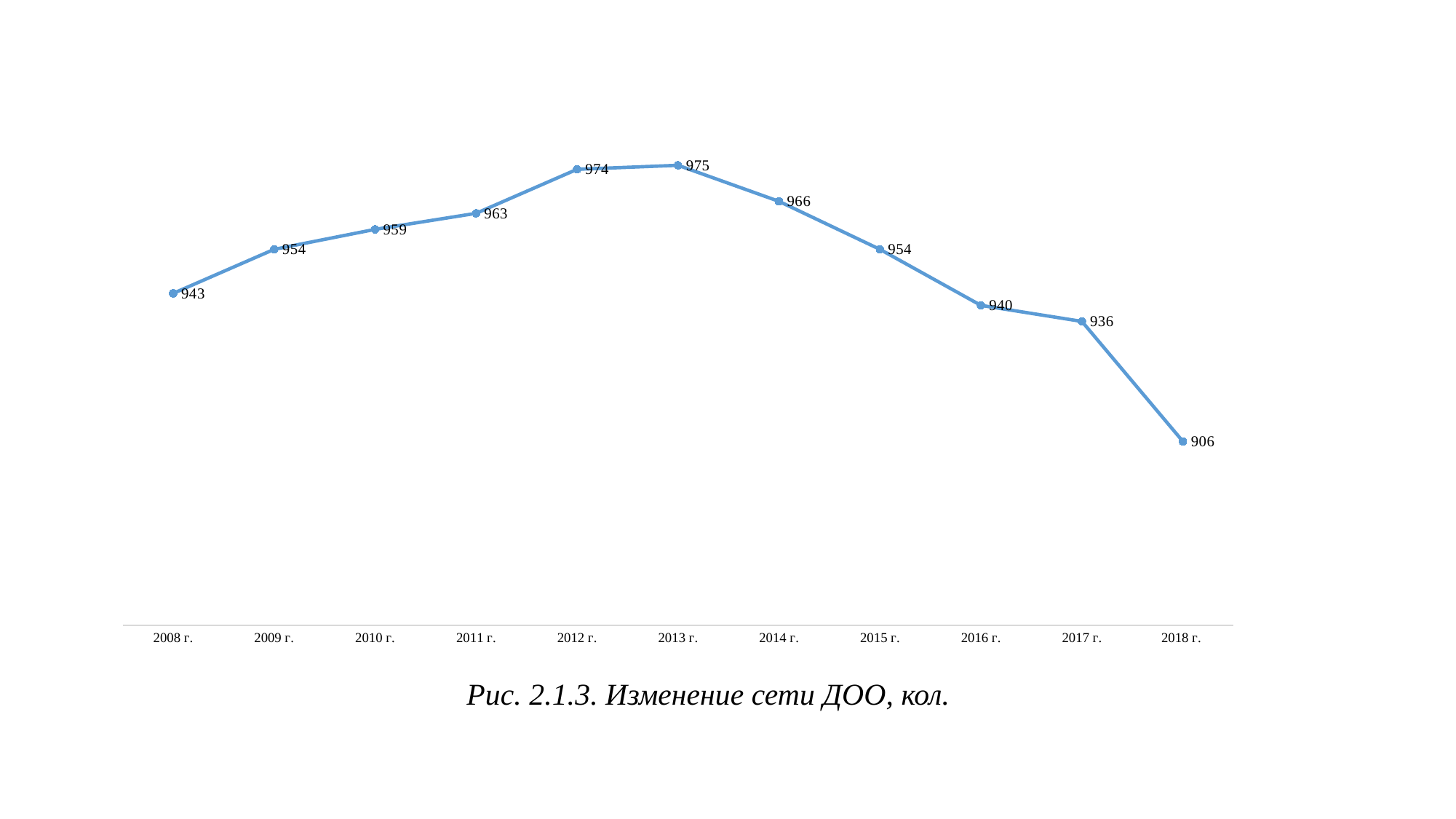
What kind of chart is this? line chart What is the difference between the values for 2013 г. and 2018 г.? 69 What is the value for 2013 г.? 975 Which year has the lowest value? 2018 г. What is the difference between the values for 2008 г. and 2012 г.? 31 Do the values rise or fall from 2013 г. to 2018 г.? fall How many years are plotted on the chart? 11 What is the value for 2018 г.? 906 What is the value for 2008 г.? 943 Which year has the highest value? 2013 г. Which is larger, the value for 2011 г. or the value for 2017 г.? 2011 г. What is the value for 2016 г.? 940